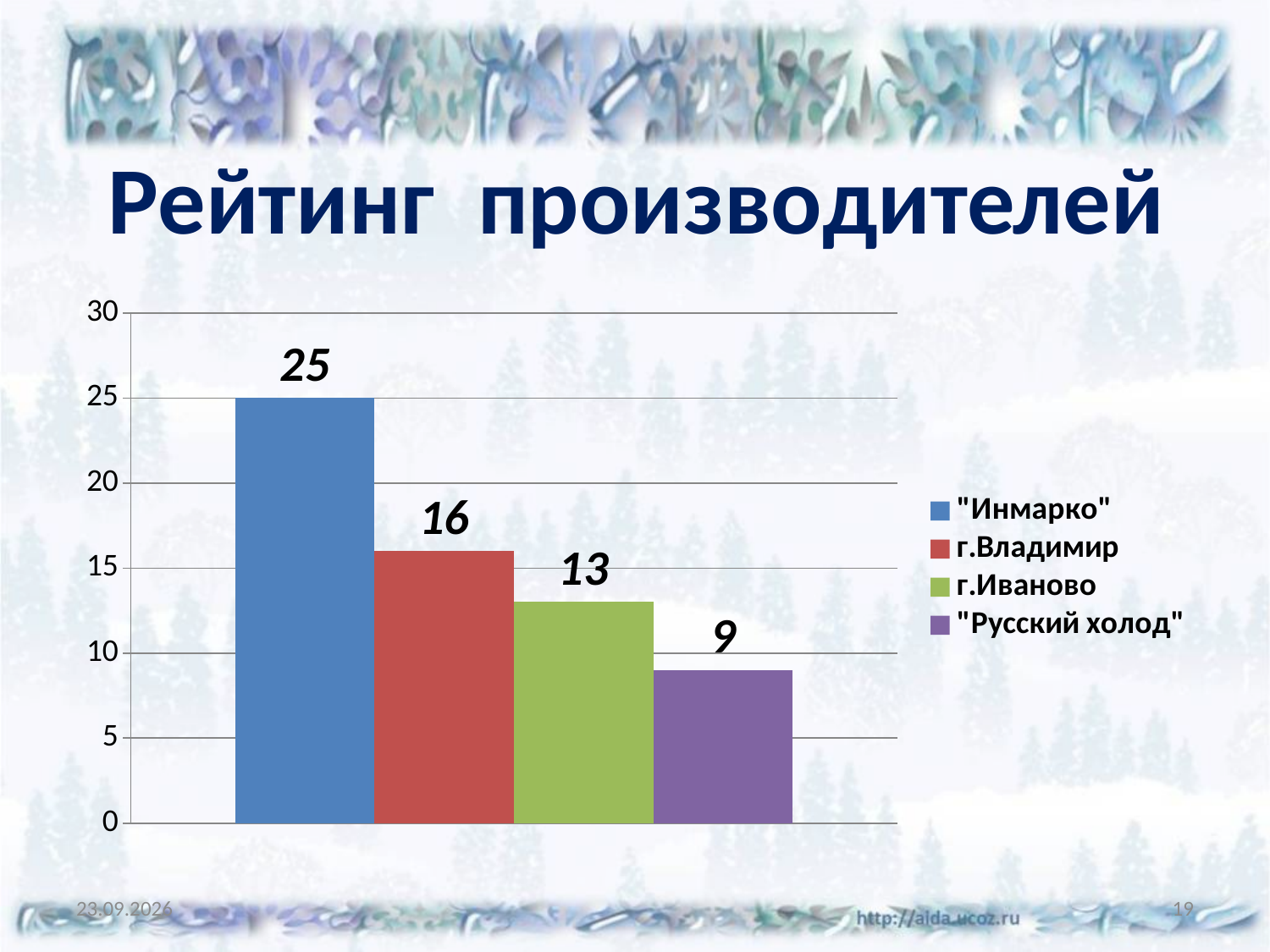
Is the value for г.Владимир greater or less than 15? greater What is the difference between the values for "Инмарко" and г.Владимир? 9 What is the value for г.Владимир? 16 What is the value for г.Иваново? 13 What is the value for "Инмарко"? 25 Which producer has the lowest value? "Русский холод" Which is larger, the value for г.Иваново or the value for "Русский холод"? г.Иваново What is the title of the slide? Рейтинг производителей What kind of chart is shown on the slide? bar chart What is the value for "Русский холод"? 9 How many producers are shown in the chart? 4 Which producer has the highest value? "Инмарко"